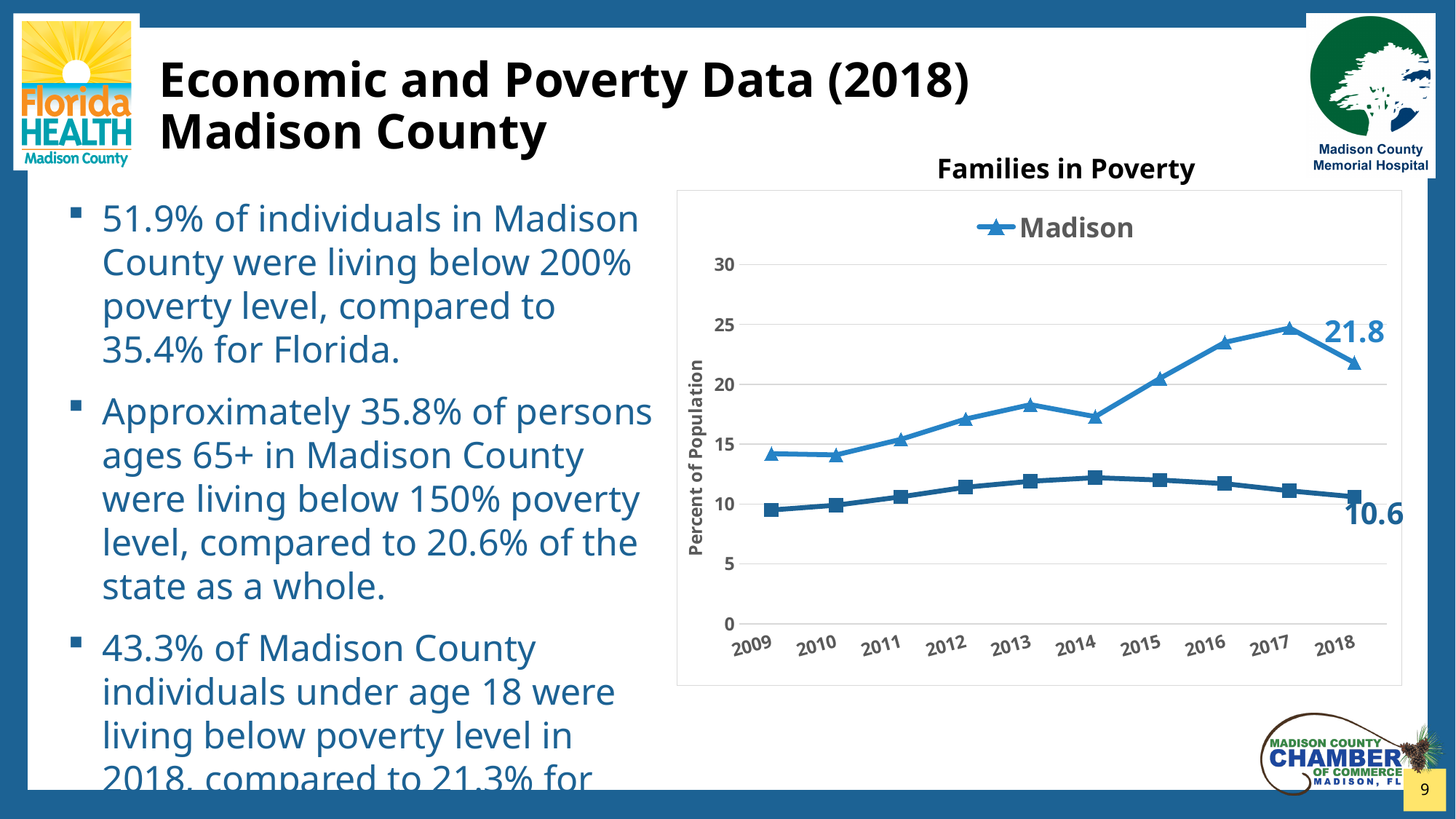
How many series does the legend of the Families in Poverty chart list? 1 In the Families in Poverty chart, is the Madison value for 2016 greater or less than 20? greater In the Families in Poverty chart, what is the difference between the two labelled 2018 values, 21.8 and 10.6? 11.2 In the Families in Poverty chart, is the Madison value for 2009 greater or less than 15? less How many years are shown on the x axis of the Families in Poverty chart? 10 In the Families in Poverty chart, what is the value for Madison in 2018? 21.8 In the Families in Poverty chart, is the 2014 value of the dark blue line with square markers greater or less than 15? less In the Families in Poverty chart, in which year does the Madison line reach its highest value? 2017 In the Families in Poverty chart, which line has the higher value in 2018, Madison or the dark blue line with square markers? Madison In the Families in Poverty chart, what is the 2018 value for the dark blue line with square markers? 10.6 What kind of chart is the Families in Poverty chart? line chart In the Families in Poverty chart, does the Madison line rise or fall from 2014 to 2017? rise